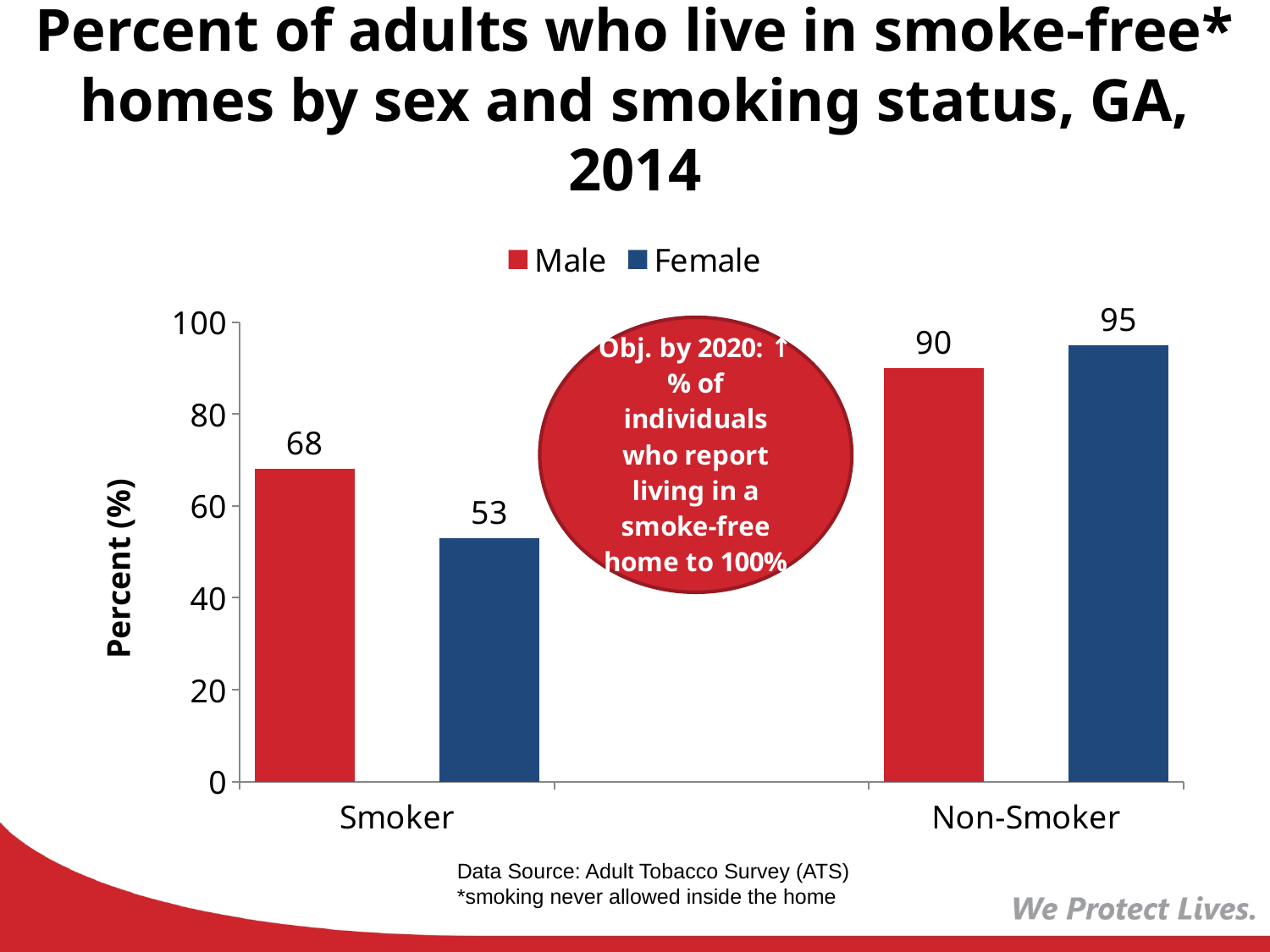
What is the value for Female in the Smoker category? 53 What is the label of the y axis? Percent (%) What kind of chart is shown on the slide? Bar chart What is the difference between the Male and Female values in the Smoker category? 15 Which is larger in the Non-Smoker category, Male or Female? Female What is the value for Male in the Non-Smoker category? 90 How many series does the legend list? 2 Which bar has the lowest value on the chart? Female, Smoker What is the value for Male in the Smoker category? 68 Which bar has the highest value on the chart? Female, Non-Smoker What is the difference between the Female values for Non-Smoker and Smoker? 42 What is the value for Female in the Non-Smoker category? 95